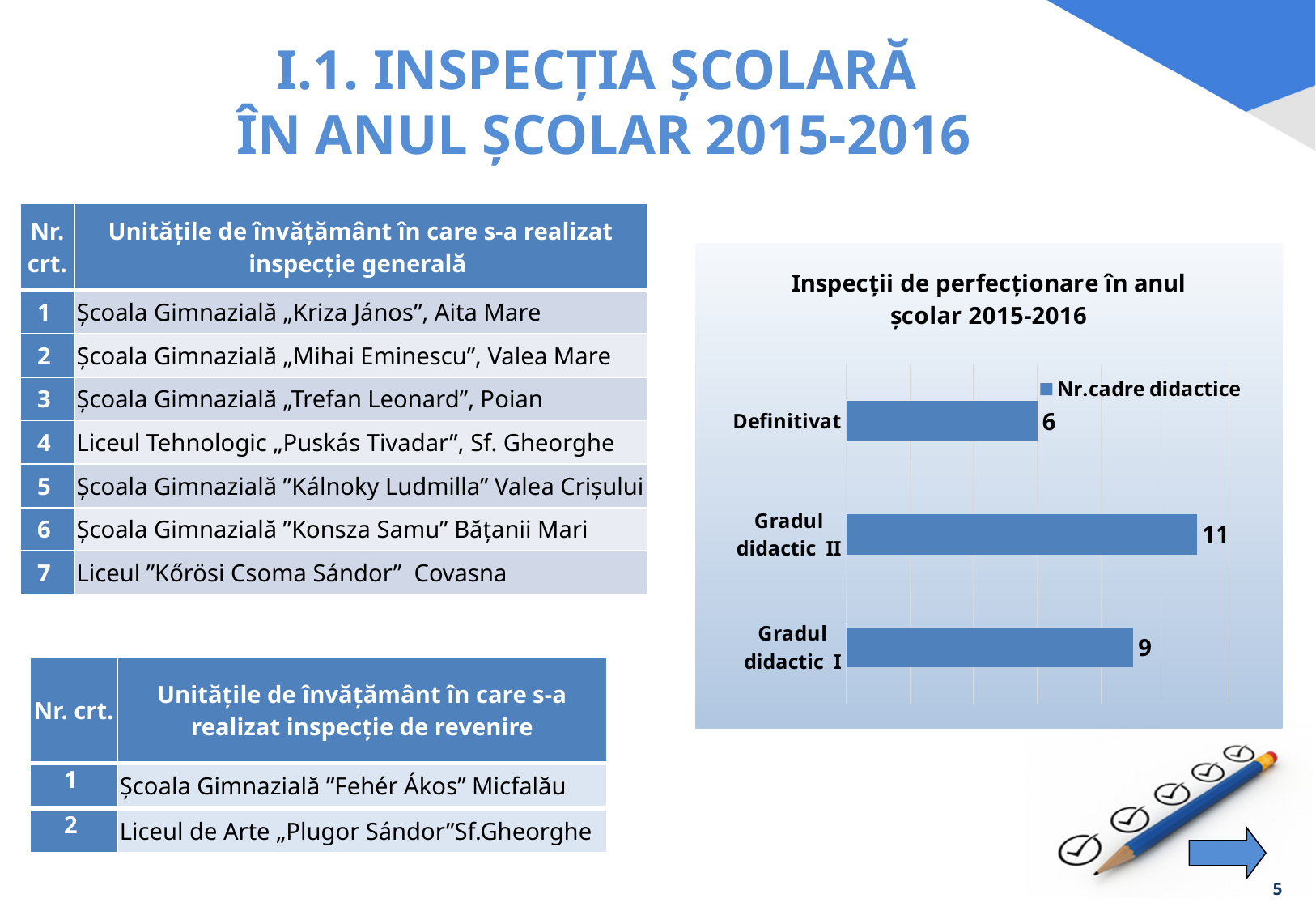
Which category has the lowest value in the chart? Definitivat What is the title of the chart? Inspecții de perfecționare în anul școlar 2015-2016 What is the value for Gradul didactic I in the chart? 9 What kind of chart is shown on the slide? bar chart What is the value for Gradul didactic II in the chart? 11 Which is larger, the value for Gradul didactic I or the value for Definitivat? Gradul didactic I What is the difference between the values for Gradul didactic I and Definitivat? 3 How many series does the chart legend list? 1 What is the difference between the values for Gradul didactic II and Gradul didactic I? 2 What is the value for Definitivat in the chart? 6 How many categories are shown in the chart? 3 Which category has the highest value in the chart? Gradul didactic II